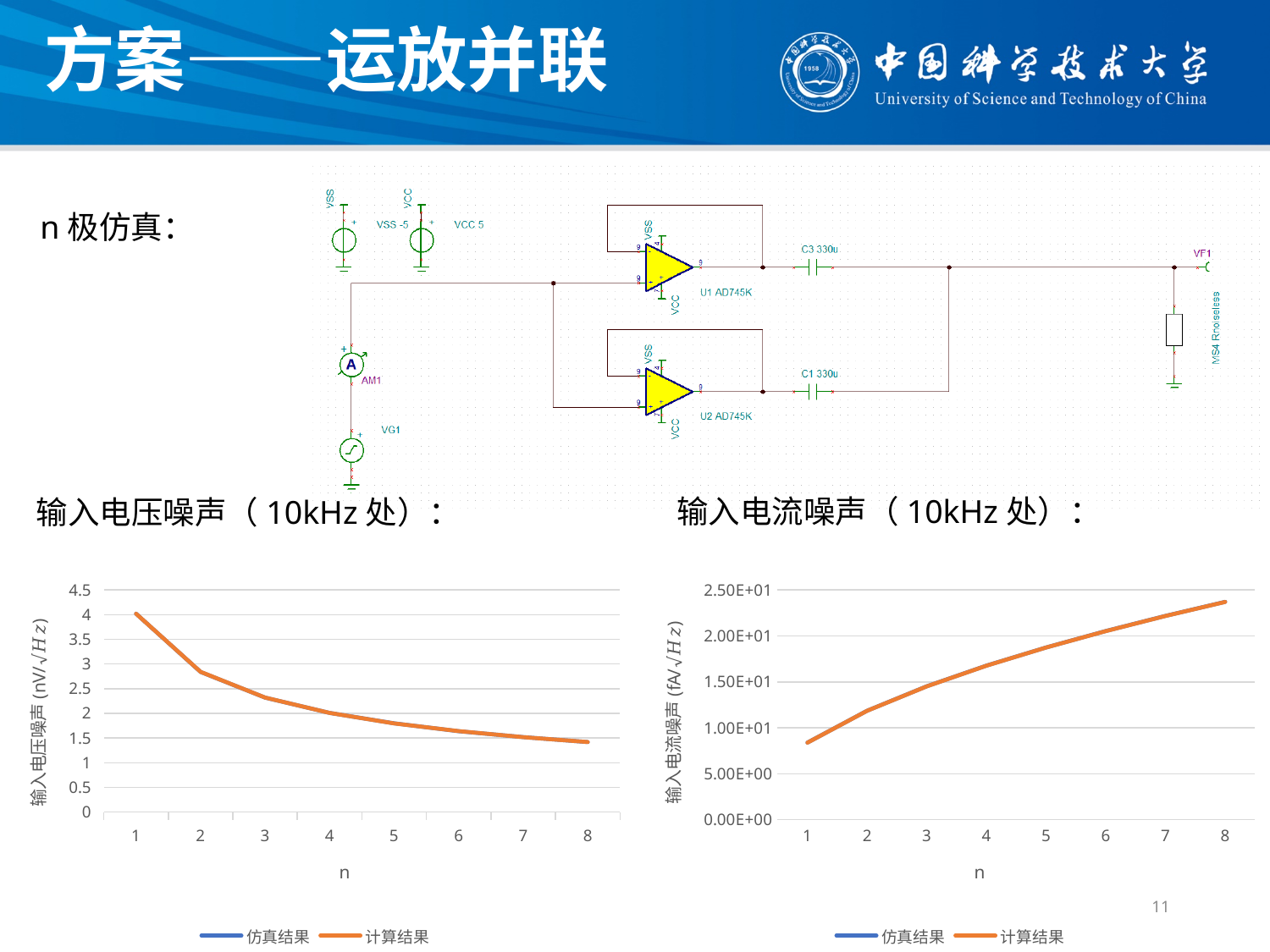
In the 输入电压噪声 (10kHz 处) chart on the left, do the values rise or fall as n increases from 1 to 8? fall In the 输入电压噪声 (10kHz 处) chart on the left, is the value at n = 1 greater or less than 3.5? greater How many series does the legend of the 输入电压噪声 (10kHz 处) chart on the left list? 2 In the 输入电流噪声 (10kHz 处) chart on the right, is the value at n = 8 greater or less than 2.00E+01? greater In the 输入电压噪声 (10kHz 处) chart on the left, at which n is the value highest? 1 In the 输入电流噪声 (10kHz 处) chart on the right, do the values rise or fall as n increases from 1 to 8? rise What are the two legend entries of the 输入电流噪声 (10kHz 处) chart on the right? 仿真结果 and 计算结果 How many n values are plotted along the x axis of the 输入电流噪声 (10kHz 处) chart on the right? 8 In the 输入电流噪声 (10kHz 处) chart on the right, at which n is the value lowest? 1 In the 输入电压噪声 (10kHz 处) chart on the left, is the value at n = 8 greater or less than 2? less What type of chart is the 输入电压噪声 (10kHz 处) chart on the left? line chart